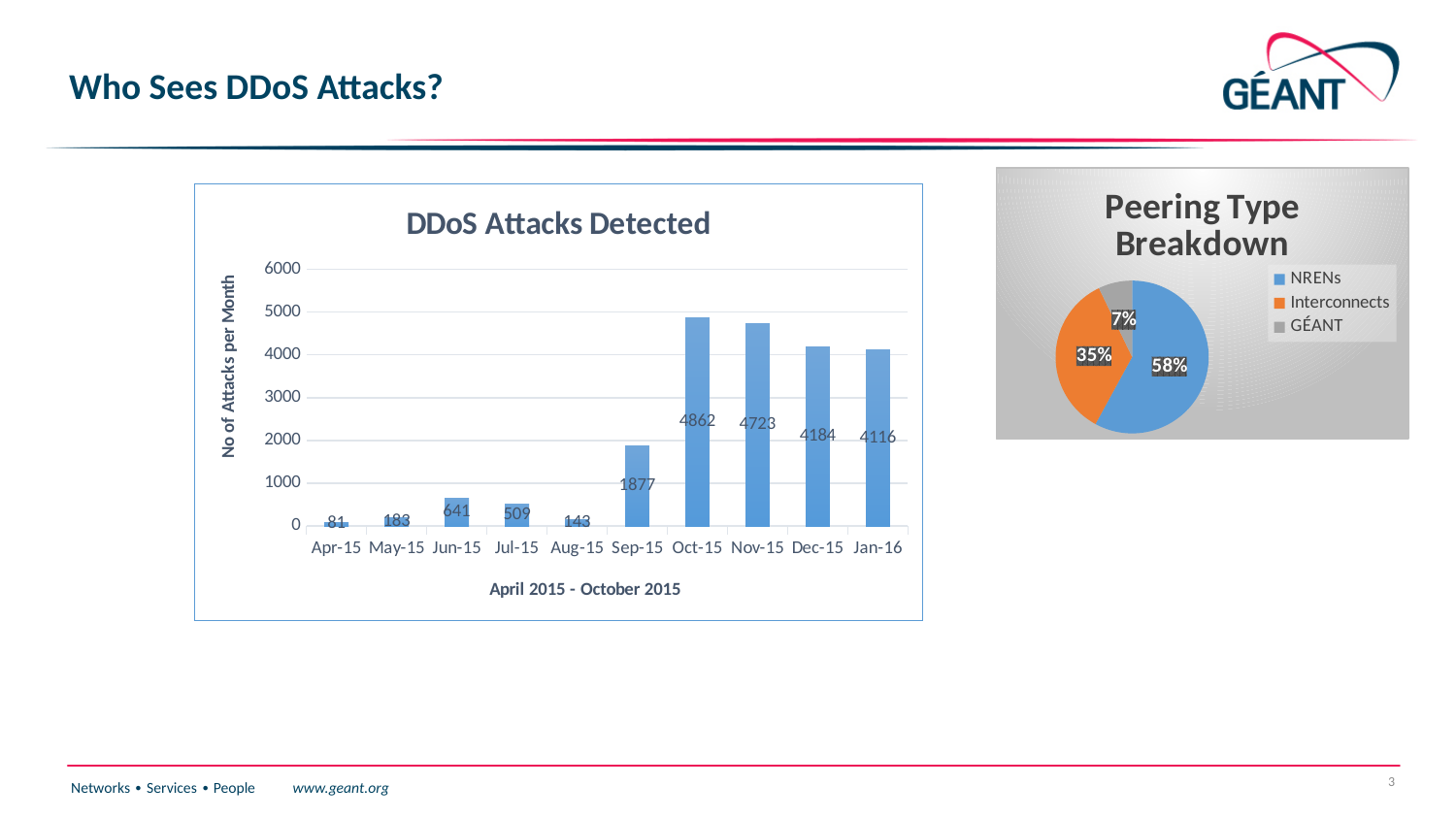
How many months are shown on the x axis of the DDoS Attacks Detected chart? 10 How many entries does the legend of the Peering Type Breakdown chart list? 3 In the DDoS Attacks Detected chart, is the value for Dec-15 greater or less than 4000? greater What kind of chart is the DDoS Attacks Detected chart? bar chart In the DDoS Attacks Detected chart, what is the difference between the values for Oct-15 and Nov-15? 139 In the DDoS Attacks Detected chart, which month has the lowest number of attacks? Apr-15 In the Peering Type Breakdown pie chart, what share is NRENs? 58% In the Peering Type Breakdown pie chart, which category has the smallest slice? GÉANT In the DDoS Attacks Detected chart, what is the value for Sep-15? 1877 In the DDoS Attacks Detected chart, which month has the highest number of attacks? Oct-15 In the DDoS Attacks Detected chart, how many attacks were detected in Oct-15? 4862 In the DDoS Attacks Detected chart, which is larger, the value for Jun-15 or the value for Jul-15? Jun-15